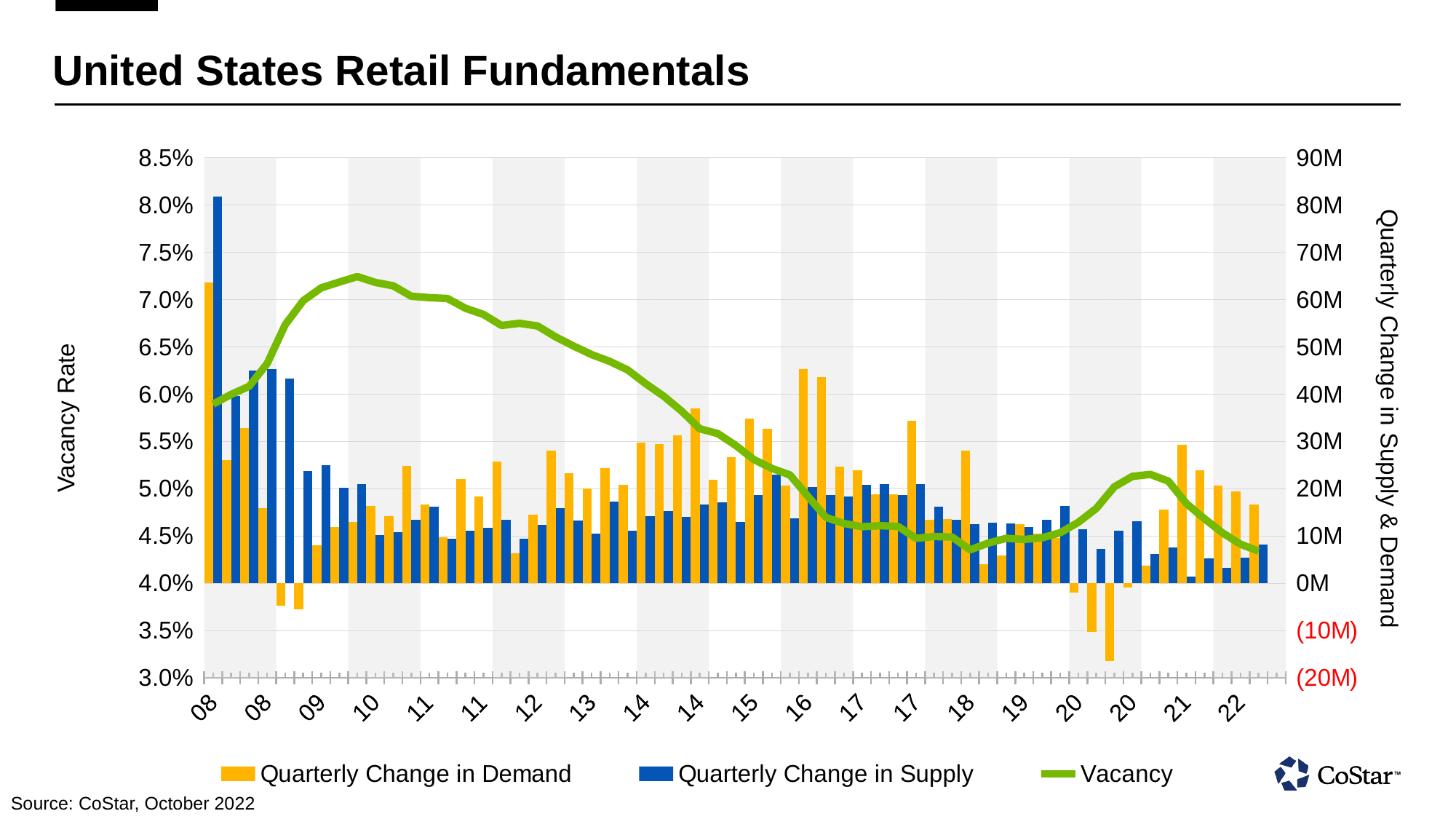
Does the Vacancy line rise or fall between 08 and 10? rise Which series is plotted as a line rather than bars? Vacancy Is the tallest Quarterly Change in Supply bar greater or less than 70M? greater What kind of chart is this? Combination bar and line chart Around which year does the Vacancy line reach its highest point? 10 Which bar is the tallest Quarterly Change in Supply bar on the chart? The first bar, at 08 Is the peak value of the Vacancy line greater or less than 7.0%? greater Is the lowest Quarterly Change in Demand bar (around 20) greater or less than (10M)? less How many series does the legend list? 3 What is the title of the left vertical axis? Vacancy Rate Does the Vacancy line rise or fall between 10 and 18? fall